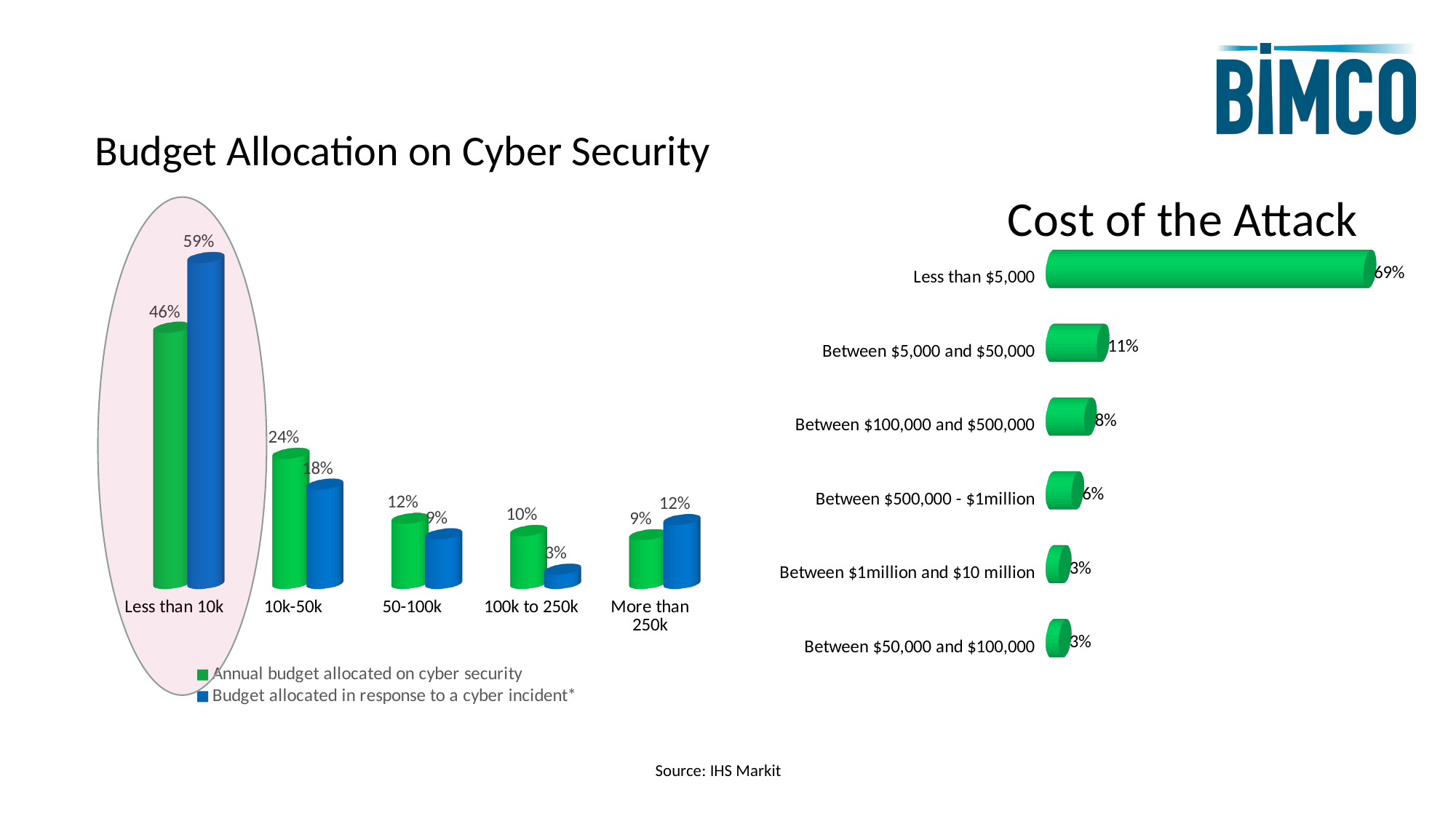
In the Cost of the Attack chart, what is the difference between Less than $5,000 and Between $5,000 and $50,000? 58% In the Budget Allocation on Cyber Security chart, what is the value of Budget allocated in response to a cyber incident for 10k-50k? 18% In the Cost of the Attack chart, what is the value for Between $500,000 - $1million? 6% How many categories are shown on the x axis of the Budget Allocation on Cyber Security chart? 5 What kind of chart is the Cost of the Attack chart? Bar chart In the Budget Allocation on Cyber Security chart, for More than 250k, which series is larger: Annual budget allocated on cyber security or Budget allocated in response to a cyber incident? Budget allocated in response to a cyber incident In the Cost of the Attack chart, what is the value for Less than $5,000? 69% In the Budget Allocation on Cyber Security chart, what is the value of Annual budget allocated on cyber security for Less than 10k? 46% In the Budget Allocation on Cyber Security chart, what is the difference between the two series for Less than 10k? 13% In the Budget Allocation on Cyber Security chart, which category has the lowest value for Budget allocated in response to a cyber incident? 100k to 250k In the Budget Allocation on Cyber Security chart, which category has the highest value for Budget allocated in response to a cyber incident? Less than 10k How many series does the legend of the Budget Allocation on Cyber Security chart list? 2